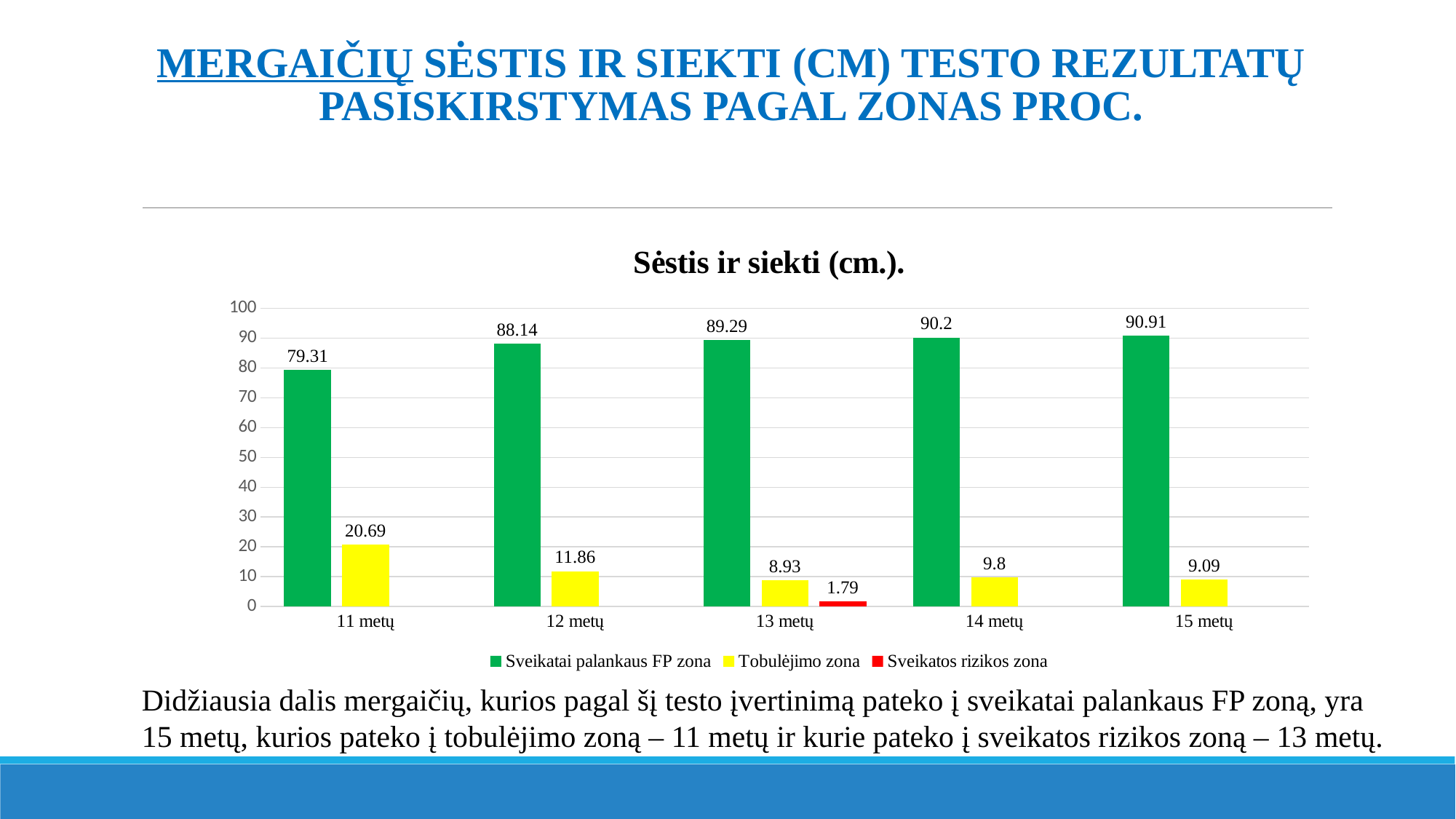
What is the title of the chart? Sėstis ir siekti (cm.). Is the value for Sveikatai palankaus FP zona for 12 metų greater or less than 80? greater How many series does the legend list? 3 What kind of chart is shown on the slide? bar chart What is the difference between the Sveikatai palankaus FP zona values for 15 metų and 11 metų? 11.6 Which age group has the highest value for Sveikatai palankaus FP zona? 15 metų Which age group has the lowest value for Tobulėjimo zona? 13 metų How many age groups are shown on the x axis? 5 What is the value for Sveikatos rizikos zona for 13 metų? 1.79 Which is larger: the Tobulėjimo zona value for 12 metų or for 14 metų? 12 metų What is the value for Sveikatai palankaus FP zona for 11 metų? 79.31 What is the value for Tobulėjimo zona for 13 metų? 8.93